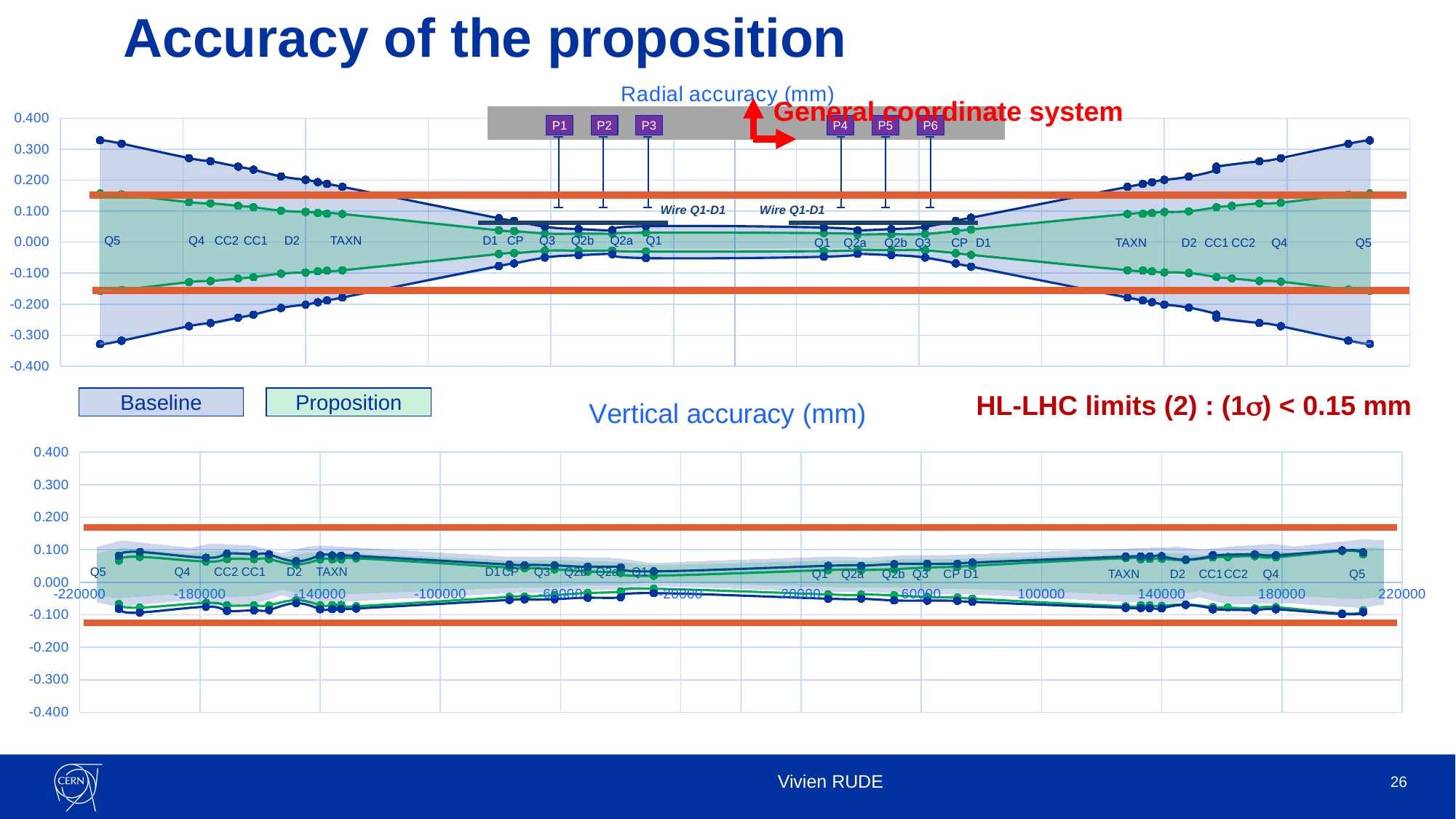
In the Vertical accuracy (mm) chart, is the upper Baseline value at Q1 near the centre greater or less than 0.100? less What kind of chart is the Radial accuracy (mm) chart? line chart In the Radial accuracy (mm) chart, which series has the larger upper value at Q5 on the far left, Baseline or Proposition? Baseline In the Radial accuracy (mm) chart, is the upper Baseline value at Q5 on the far left greater or less than 0.300? greater In the Vertical accuracy (mm) chart, is the upper Baseline value at Q5 on the far left greater or less than 0.200? less In the Radial accuracy (mm) chart, does the upper Baseline line rise or fall when moving from Q5 on the left toward Q1 near the centre? fall How many series does the legend list for the charts on this slide? 2 What is the title of the lower chart on the slide? Vertical accuracy (mm) What are the two series named in the legend? Baseline and Proposition What is the maximum value shown on the y axis of the Vertical accuracy (mm) chart? 0.400